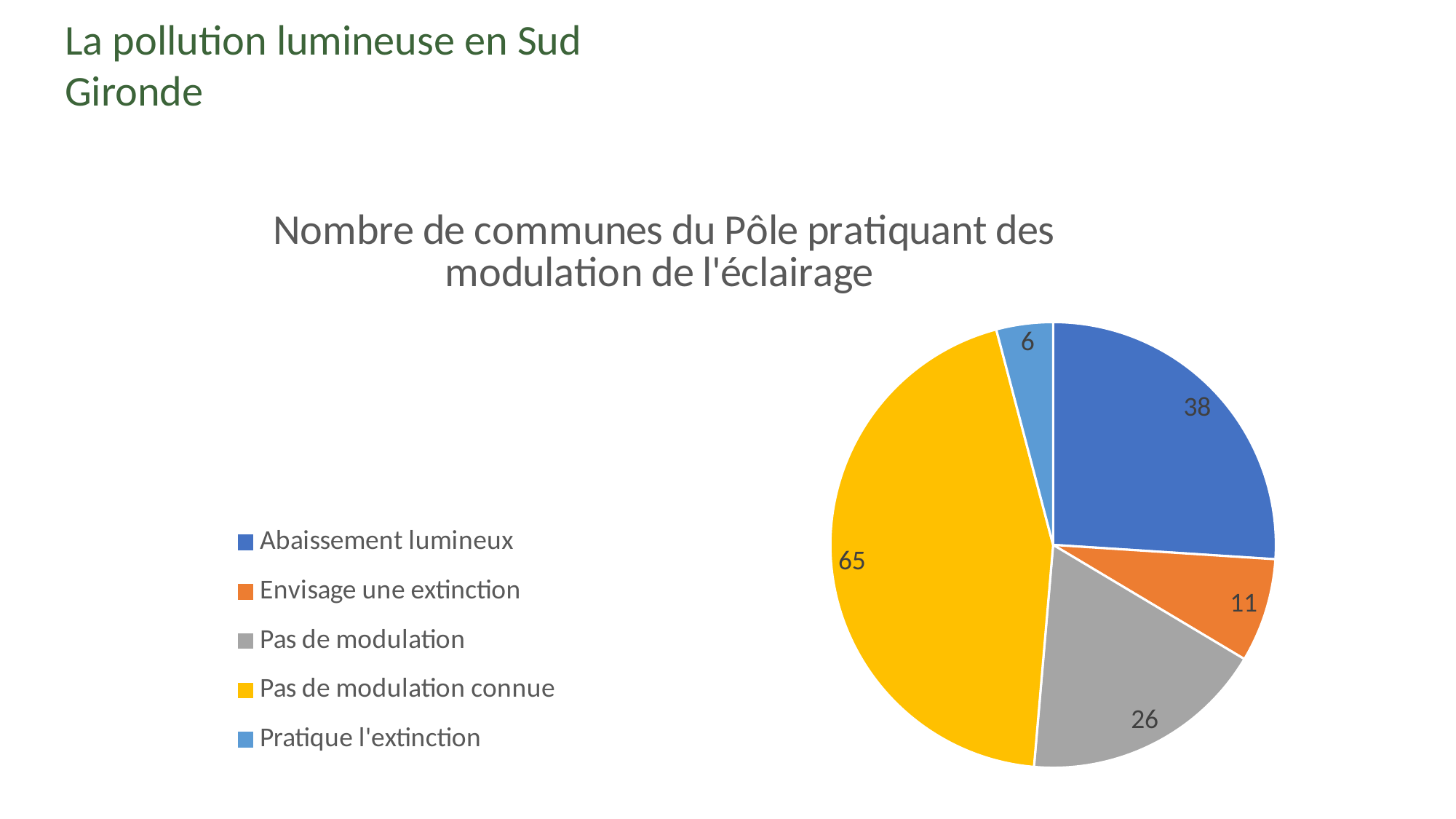
What is the value for 'Pratique l'extinction'? 6 What is the title of the chart? Nombre de communes du Pôle pratiquant des modulation de l'éclairage What share of the pie, to the nearest whole percent, does 'Pas de modulation connue' represent? 45% What type of chart is shown on the slide? pie chart What is the difference between the values for 'Pas de modulation connue' and 'Abaissement lumineux'? 27 Which category has the smallest slice? Pratique l'extinction Which category has the largest slice? Pas de modulation connue What is the value for 'Pas de modulation connue'? 65 What is the value for 'Abaissement lumineux'? 38 What is the total of all the slices in the pie chart? 146 How many slices does the pie chart have? 5 Which is larger, 'Pas de modulation' or 'Envisage une extinction'? Pas de modulation